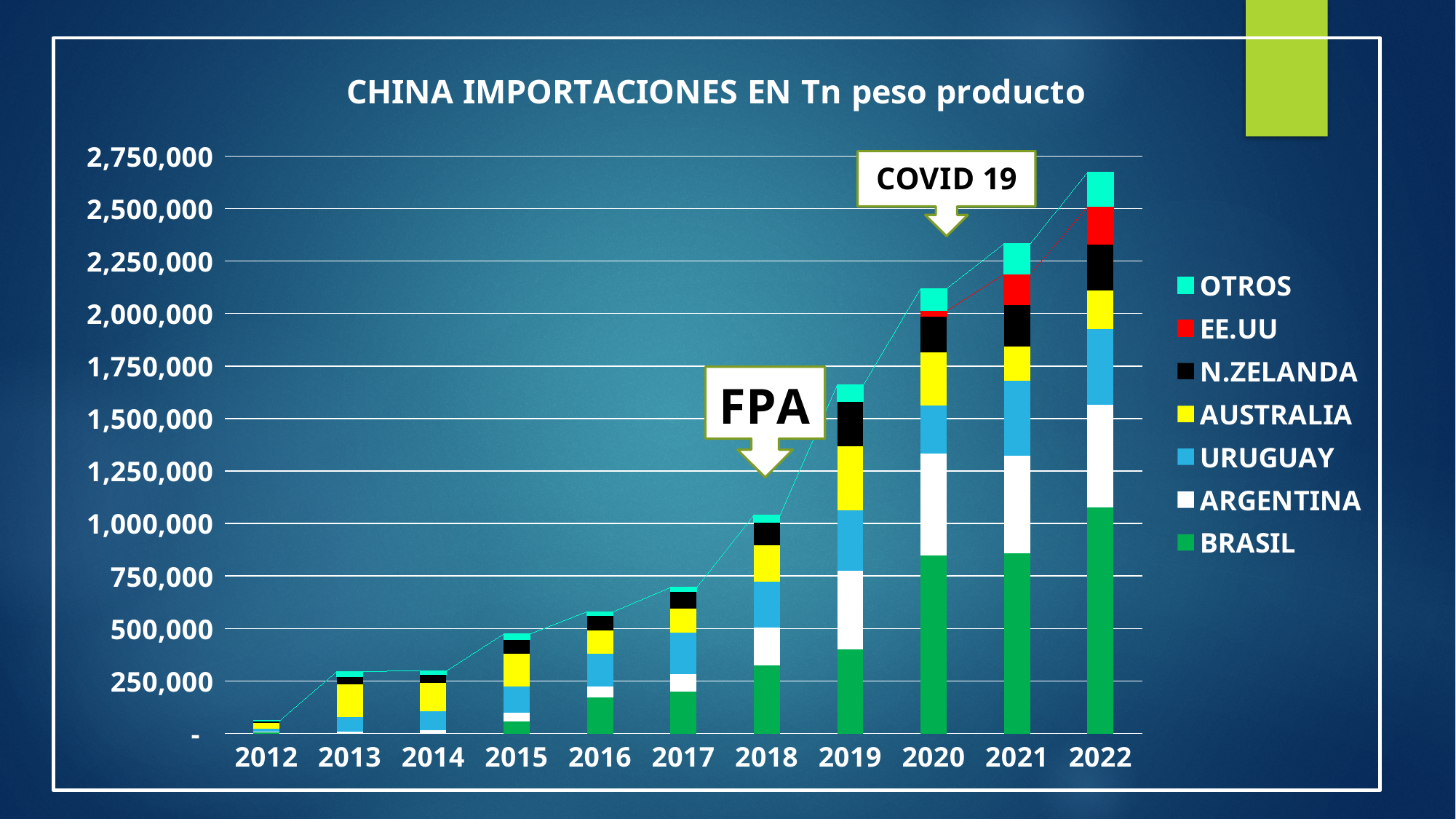
Which year has the lowest total imports? 2012 Is the total value for 2017 greater or less than 750,000? less What kind of chart is shown on the slide? Stacked bar chart How many series does the legend list? 7 Is the total value for 2022 greater or less than 2,500,000? greater Which year has the highest total imports? 2022 Which year has a larger total, 2020 or 2021? 2021 Is the total value for 2012 greater or less than 250,000? less Do total imports generally rise or fall from 2012 to 2022? rise How many years are shown on the x axis? 11 What is the title of the chart? CHINA IMPORTACIONES EN Tn peso producto